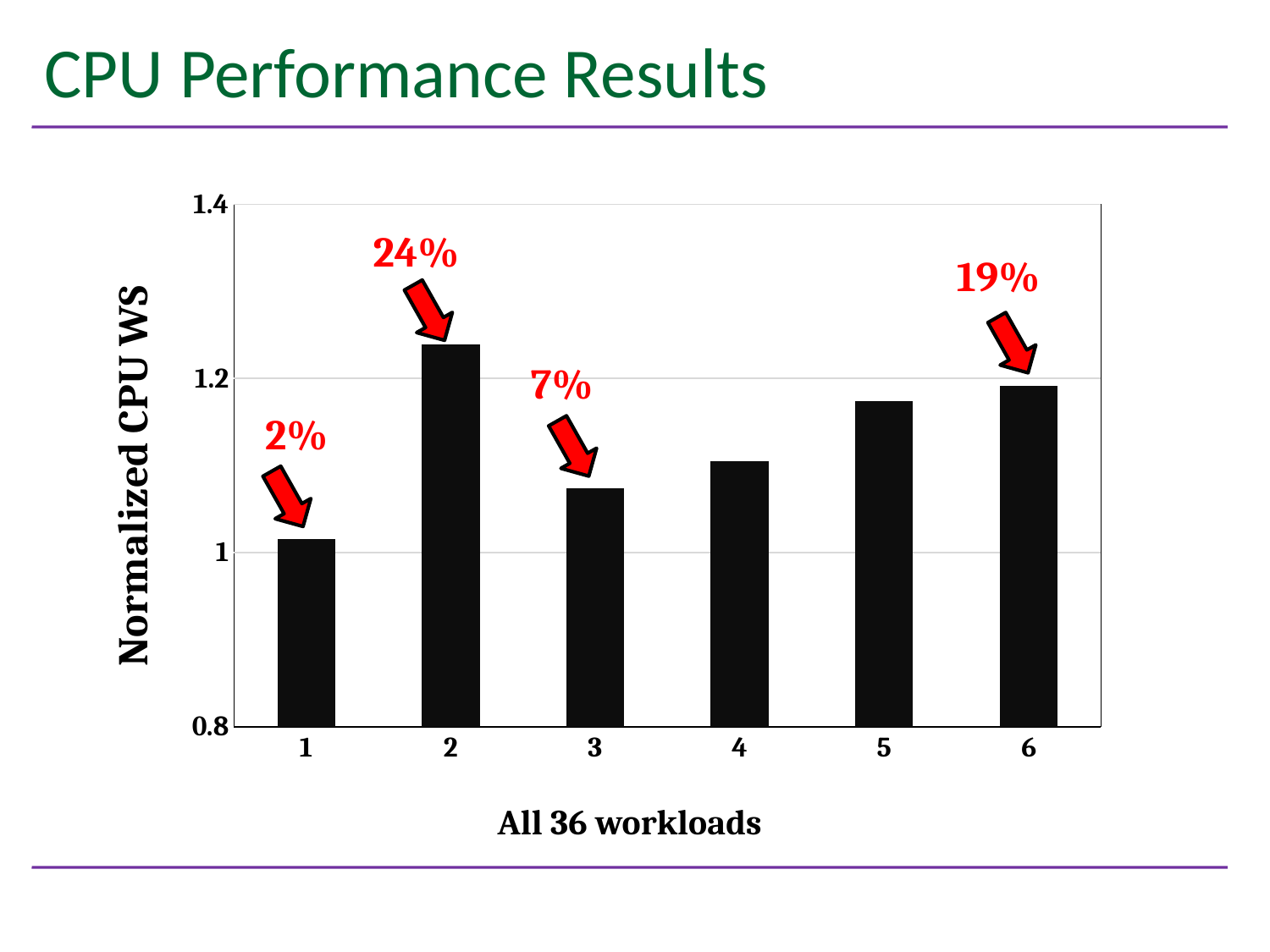
Is the value for category 3 greater or less than 1? greater How many bars are plotted in the chart? 6 What percentage is annotated above the bar for category 2? 24% What percentage is annotated above the bar for category 6? 19% What is the label of the y axis? Normalized CPU WS Which is larger, the value for category 4 or category 5? 5 Is the value for category 2 greater or less than 1.2? greater Which category has the highest Normalized CPU WS? 2 What kind of chart is shown on the slide? bar chart Which is larger, the value for category 2 or category 6? 2 Which category has the lowest Normalized CPU WS? 1 Is the value for category 4 greater or less than 1.2? less